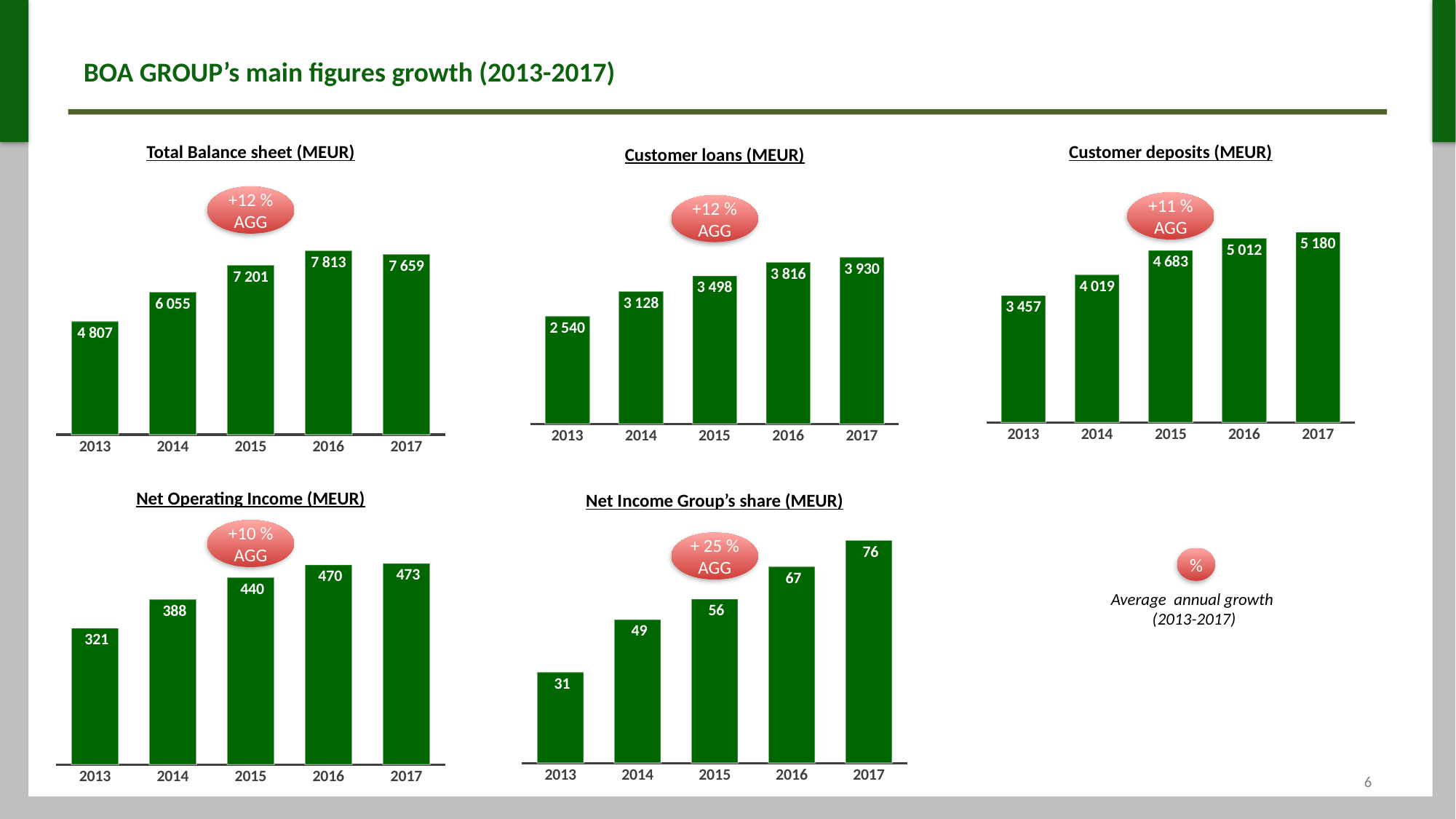
In the Total Balance sheet (MEUR) chart, what is the value for 2016? 7 813 In the Customer deposits (MEUR) chart, which year has the highest value? 2017 In the Net Operating Income (MEUR) chart, what is the value for 2013? 321 What type of chart is the Customer loans (MEUR) chart? bar chart In the Customer loans (MEUR) chart, what is the difference between the 2017 and 2013 values? 1 390 In the Customer loans (MEUR) chart, what is the value for 2015? 3 498 In the Net Income Group's share (MEUR) chart, what is the difference between the 2016 and 2015 values? 11 In the Total Balance sheet (MEUR) chart, which year has the lowest value? 2013 In the Total Balance sheet (MEUR) chart, which is larger, the value for 2016 or the value for 2017? 2016 In the Net Income Group's share (MEUR) chart, do the values rise or fall from 2013 to 2017? rise In the Customer deposits (MEUR) chart, what is the value for 2014? 4 019 In the Net Operating Income (MEUR) chart, how many years are shown? 5